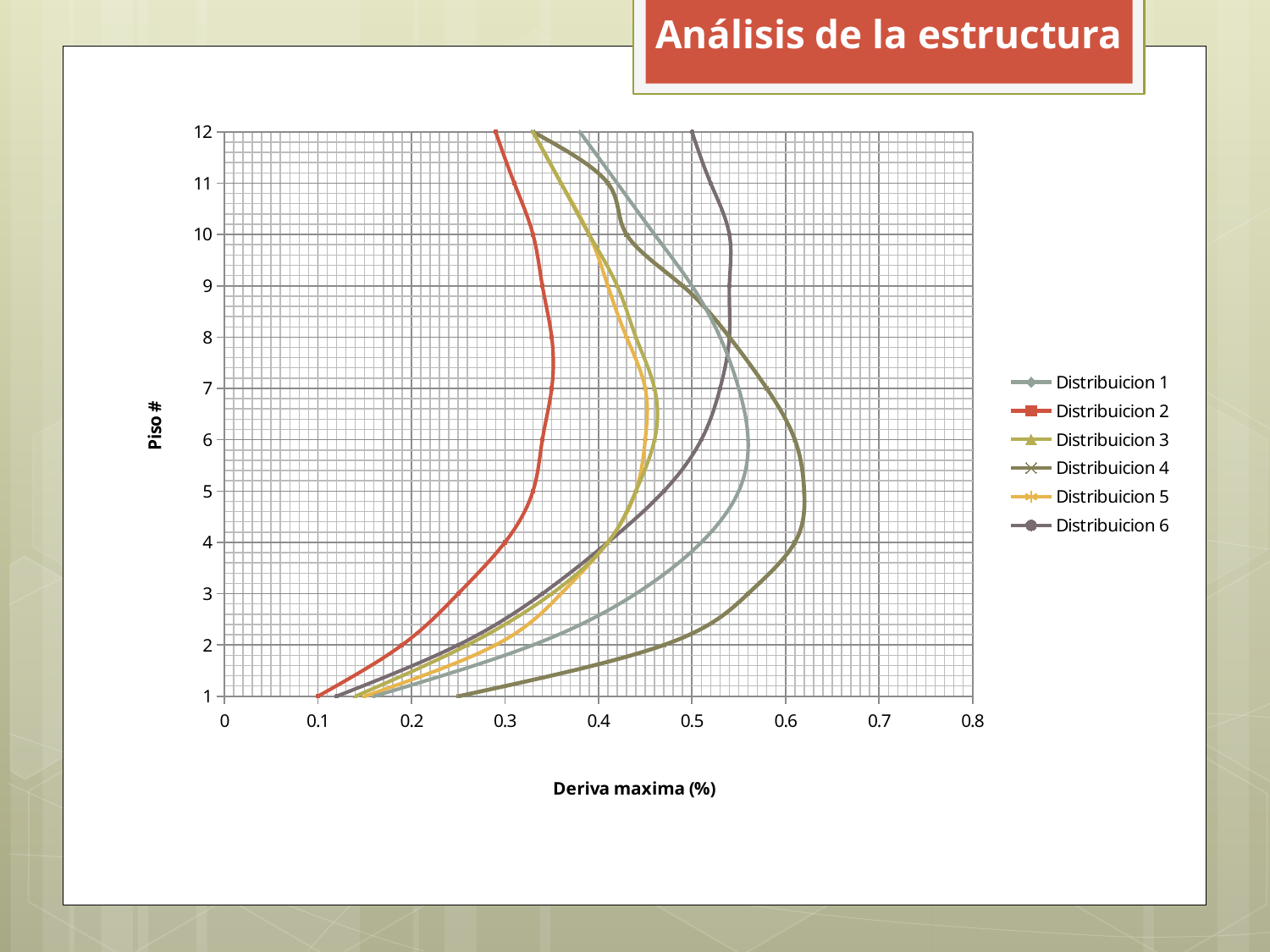
Is the value for Distribuicion 4 at floor 1 greater or less than 0.2? greater How many series does the legend list? 6 Which series reaches the highest deriva maxima on the chart? Distribuicion 4 Which series has the lowest deriva maxima at floor 7? Distribuicion 2 Is the value for Distribuicion 2 at floor 7 greater or less than 0.3? greater What is the title of the vertical axis? Piso # At floor 5, which has the larger deriva maxima: Distribuicion 4 or Distribuicion 2? Distribuicion 4 What is the title of the horizontal axis? Deriva maxima (%) What kind of chart is shown on the slide? line chart Is the value for Distribuicion 4 at floor 5 greater or less than 0.6? greater How many floors (Piso #) are shown on the vertical axis? 12